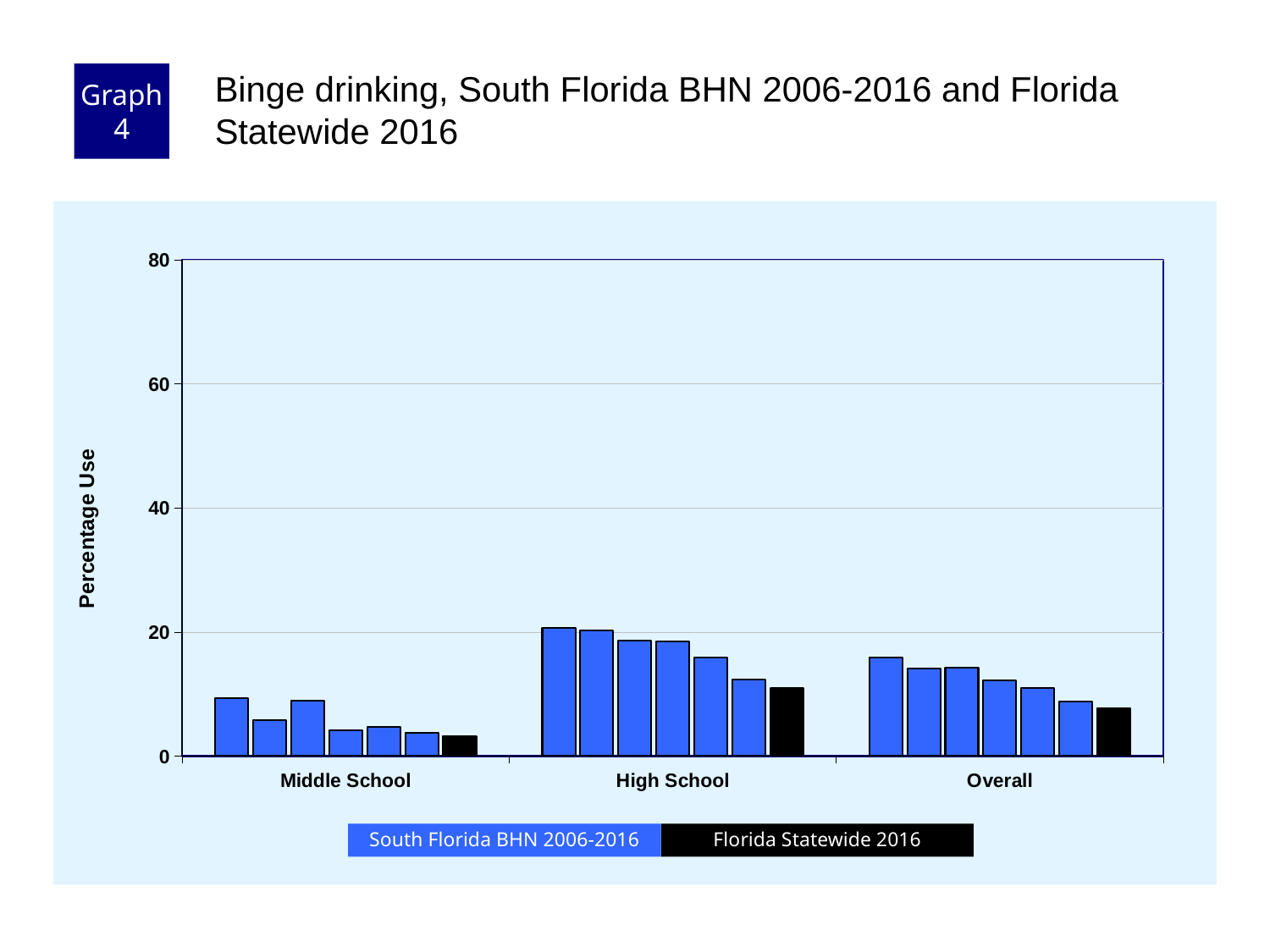
How many series does the legend list? 2 Which category has the lowest bars overall? Middle School Is the value of the tallest Middle School bar greater or less than 20? less How many categories are shown on the x axis? 3 What kind of chart is shown on the slide? bar chart Which category has the highest bars overall? High School What is the label on the y axis? Percentage Use Which is larger, the Florida Statewide 2016 value for High School or for Middle School? High School Is the value of the tallest High School bar greater or less than 40? less Do the South Florida BHN 2006-2016 bars for High School rise or fall from left to right? fall What colour are the Florida Statewide 2016 bars? black Is the Florida Statewide 2016 value for High School greater or less than 20? less